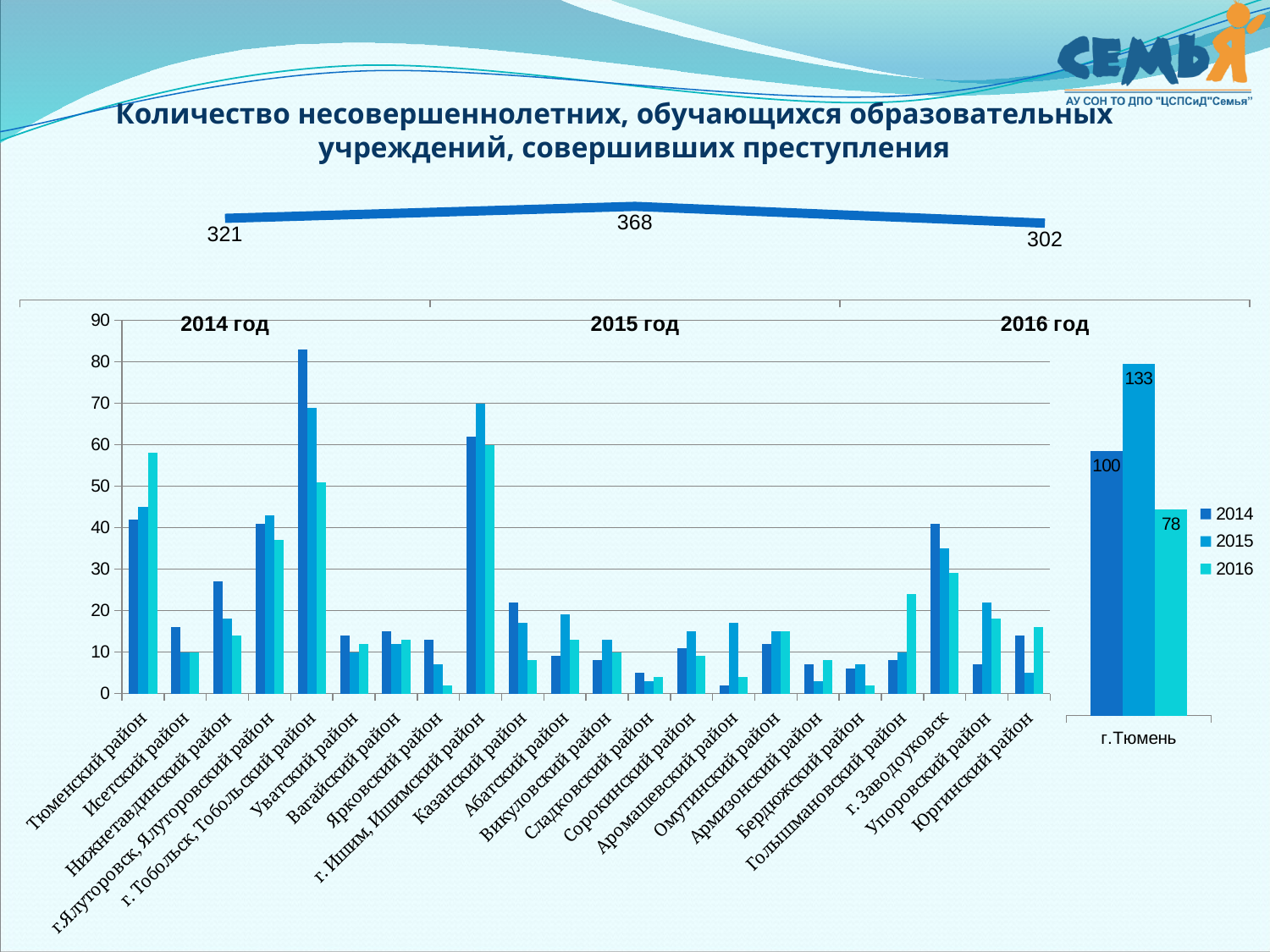
On the small bar chart for г.Тюмень, what is the value for 2016? 78 On the line chart at the top of the slide, what value is shown for 2015 год? 368 On the line chart at the top of the slide, what value is shown for 2016 год? 302 On the large bar chart, is the 2014 value for г. Тобольск, Тобольский район greater or less than 80? greater On the line chart at the top of the slide, what is the difference between the 2015 and 2016 values? 66 On the line chart at the top of the slide, which year has the highest value? 2015 год On the line chart at the top of the slide, which year has the lowest value? 2016 год How many districts are shown on the large bar chart in the lower left? 22 On the line chart at the top of the slide, how does the value change from 2014 to 2016? It rises from 321 to 368, then falls to 302 On the small bar chart for г.Тюмень, what is the difference between the 2014 and 2016 values? 22 On the small bar chart for г.Тюмень, what is the value for 2015? 133 How many series does the legend of the г.Тюмень bar chart list? 3